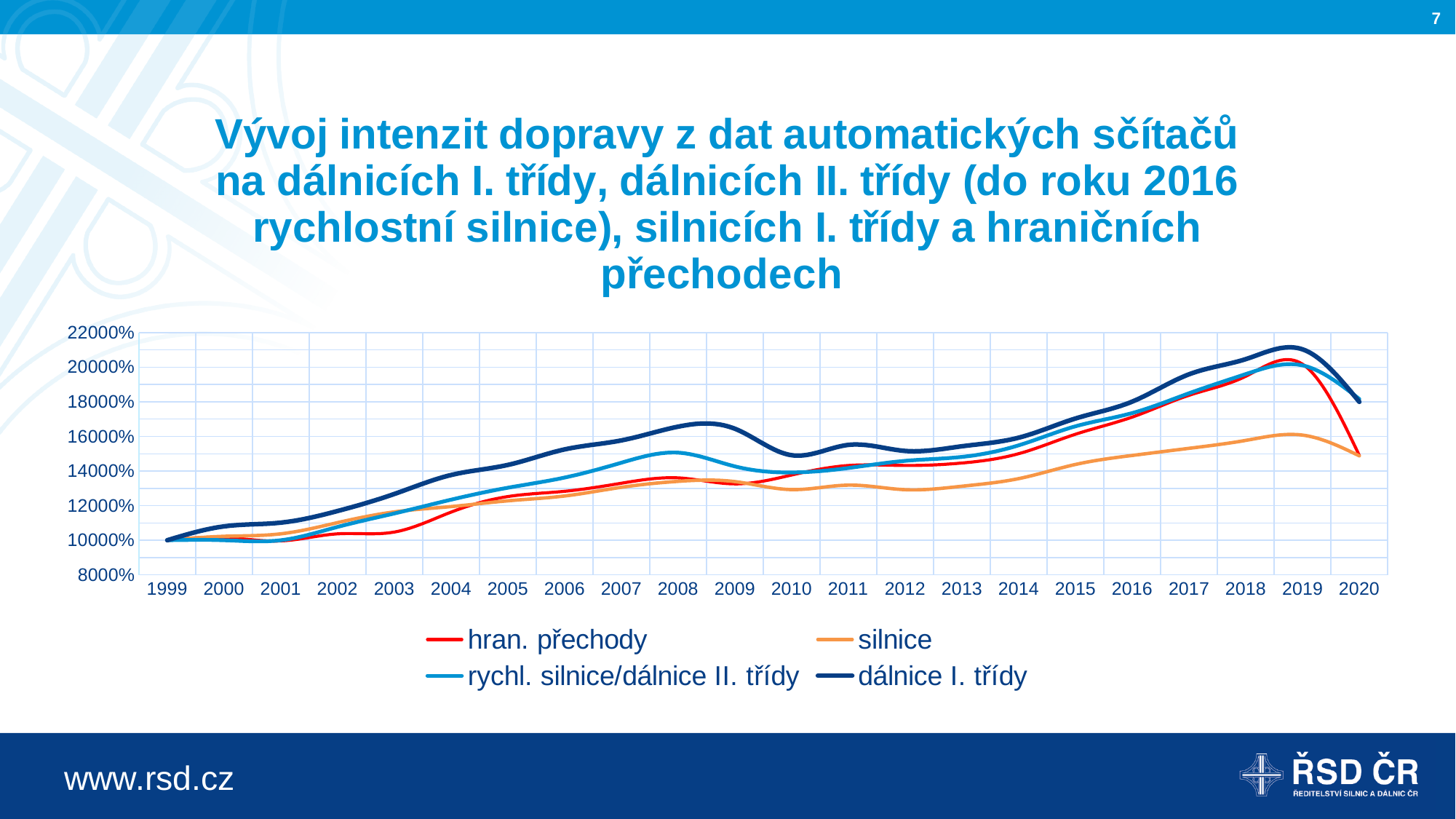
Which series has the lowest value in 2019? silnice Does the value for silnice rise or fall from 1999 to 2019? rise In 2008, which is larger: the value for dálnice I. třídy or the value for silnice? dálnice I. třídy Is the value for dálnice I. třídy in 2019 greater or less than 20000%? greater What colour is the line for hran. přechody? red How many years are shown along the x axis? 22 Is the value for dálnice I. třídy in 2008 greater or less than 16000%? greater What is the value for dálnice I. třídy in 1999? 10000% How many series does the legend list? 4 Is the value for silnice in 2020 greater or less than 16000%? less Which series has the highest value in 2019? dálnice I. třídy What kind of chart is shown on the slide? line chart